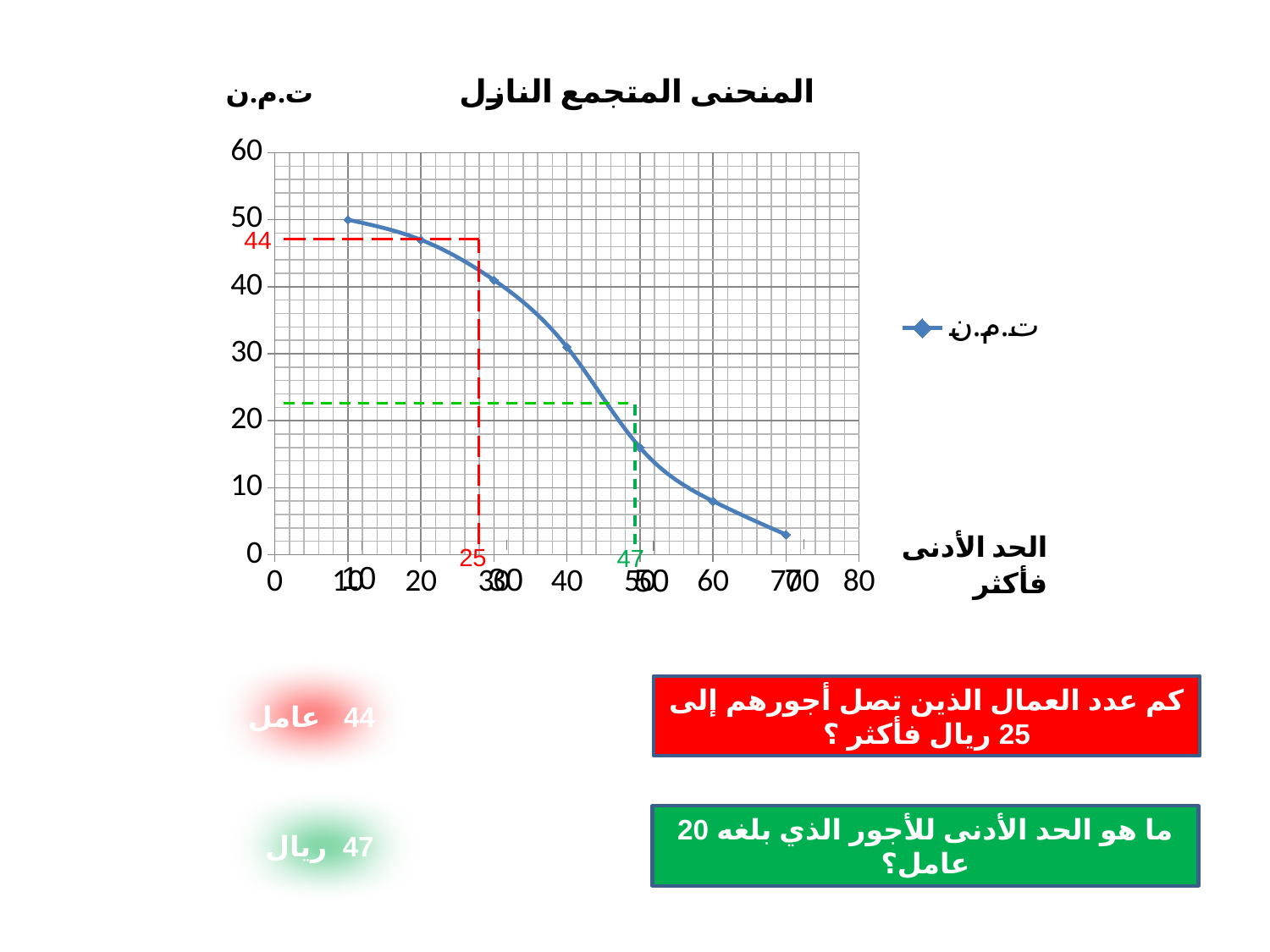
At which x-axis value is the curve highest? 10 Which is larger, the value of the curve at x = 20 or at x = 60? x = 20 Do the values of the curve rise or fall as the x-axis value increases? fall How many data points are plotted on the curve? 7 According to the red dashed annotation, what value on the y-axis corresponds to 25 on the x-axis? 44 At which x-axis value is the curve lowest? 70 What is the title of the chart? المنحنى المتجمع النازل Is the value of the curve at x = 70 greater or less than 10? less Is the value of the curve at x = 50 greater or less than 20? less What kind of chart is shown on the slide? line chart Is the value of the curve at x = 10 greater or less than 40? greater How many series does the legend list? 1